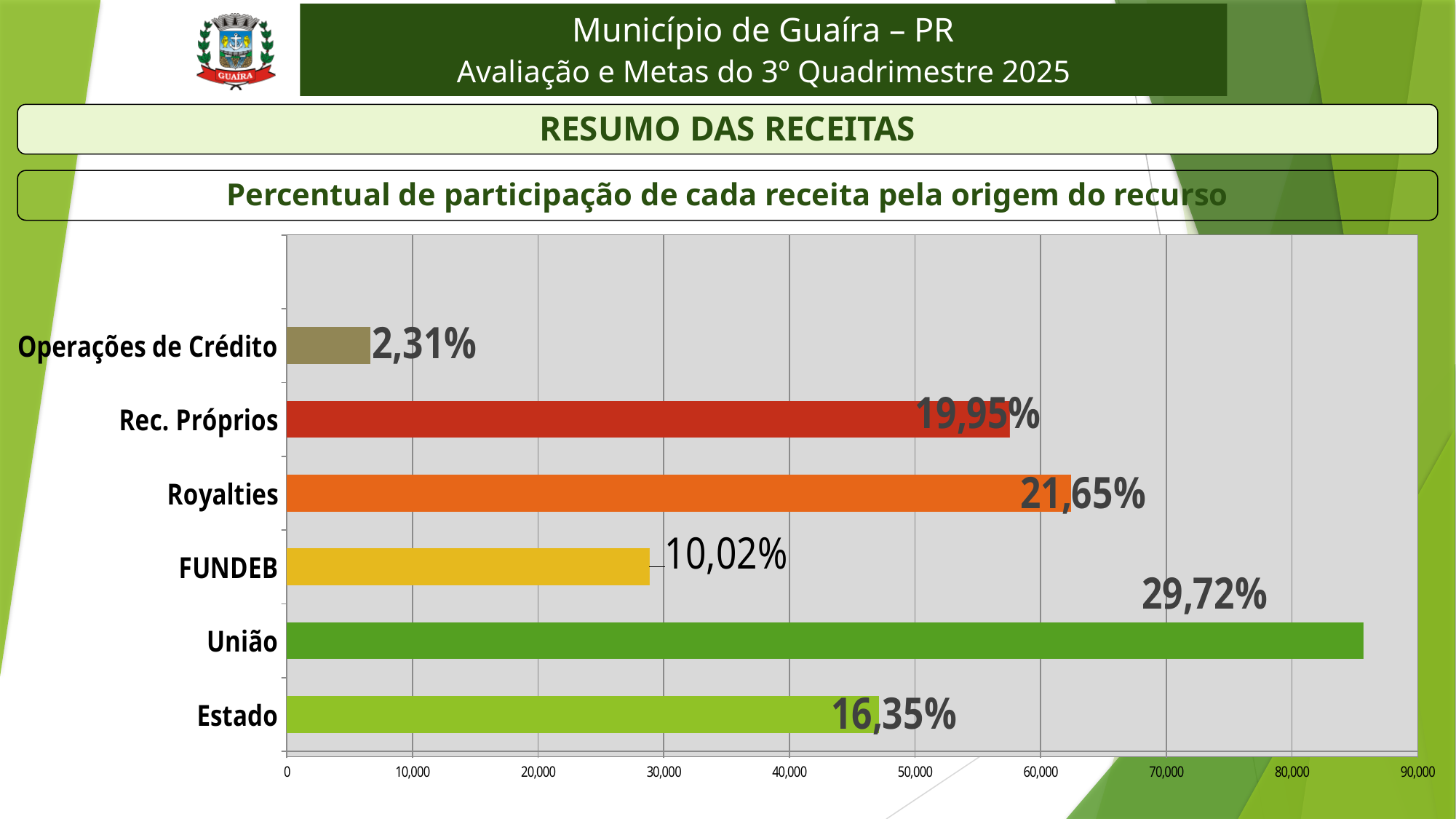
Is the bar for Operações de Crédito greater or less than 10,000 on the axis? less Which category has the highest share of revenue? União What percentage is shown for Operações de Crédito? 2,31% What is the difference in percentage points between Royalties and Rec. Próprios? 1,70 What kind of chart is shown on the slide? Bar chart What percentage is shown for FUNDEB? 10,02% Which is larger, the share for Royalties or the share for Rec. Próprios? Royalties How many categories are shown in the chart? 6 What is the difference in percentage points between União and Estado? 13,37 Is the bar for União greater or less than 80,000 on the axis? greater Which category has the lowest share of revenue? Operações de Crédito What percentage is shown for União? 29,72%